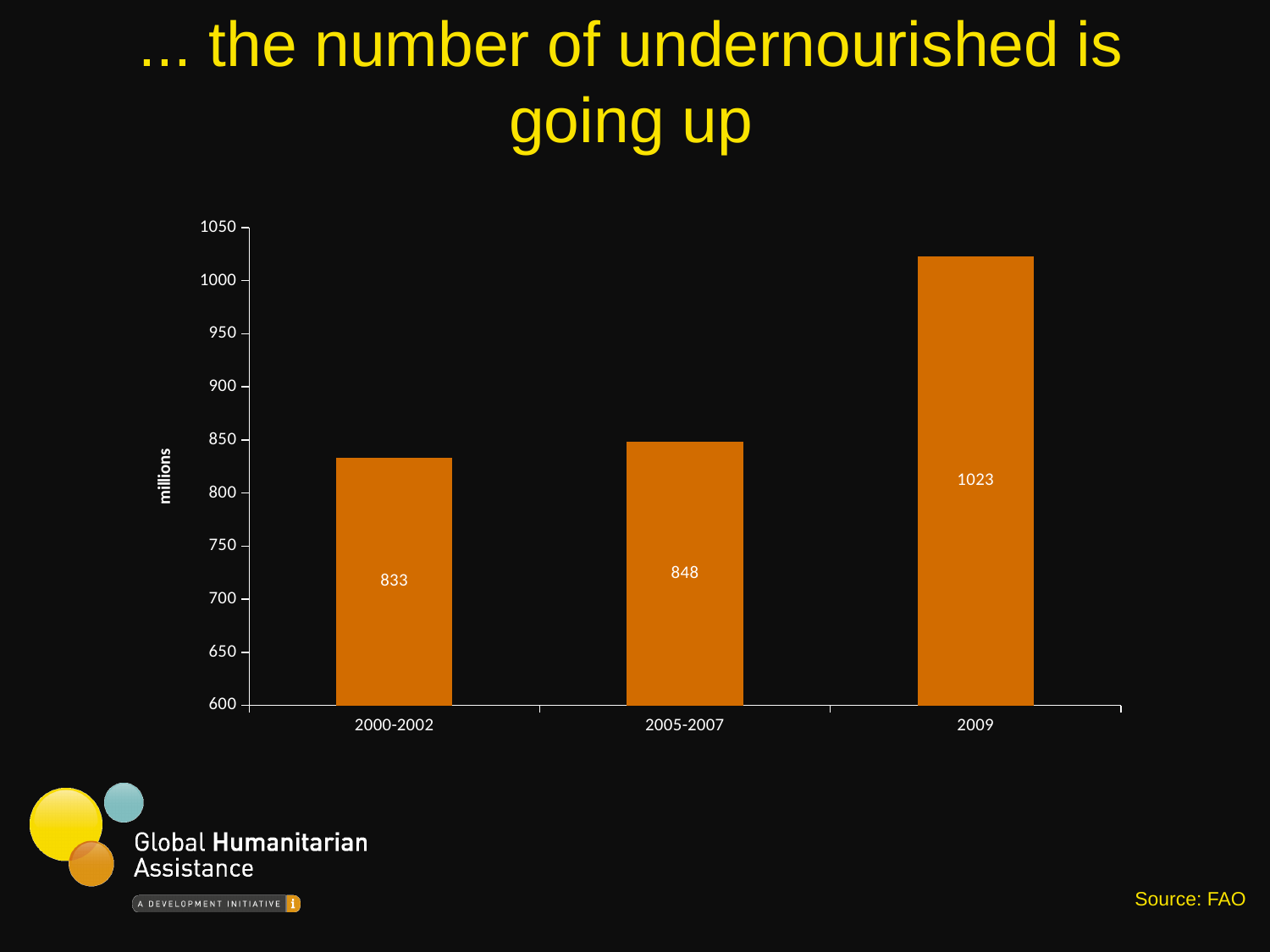
Do the values rise or fall from 2000-2002 to 2009? rise How many periods are shown on the x axis? 3 What is the difference between the values for 2009 and 2000-2002? 190 Which is larger, the value for 2009 or the value for 2005-2007? 2009 What is the difference between the values for 2005-2007 and 2000-2002? 15 Which period has the highest value? 2009 Is the value for 2009 greater or less than 1000? greater What kind of chart is shown on the slide? bar chart What is the value for 2005-2007? 848 What is the value for 2000-2002? 833 Which period has the lowest value? 2000-2002 What is the value for 2009? 1023